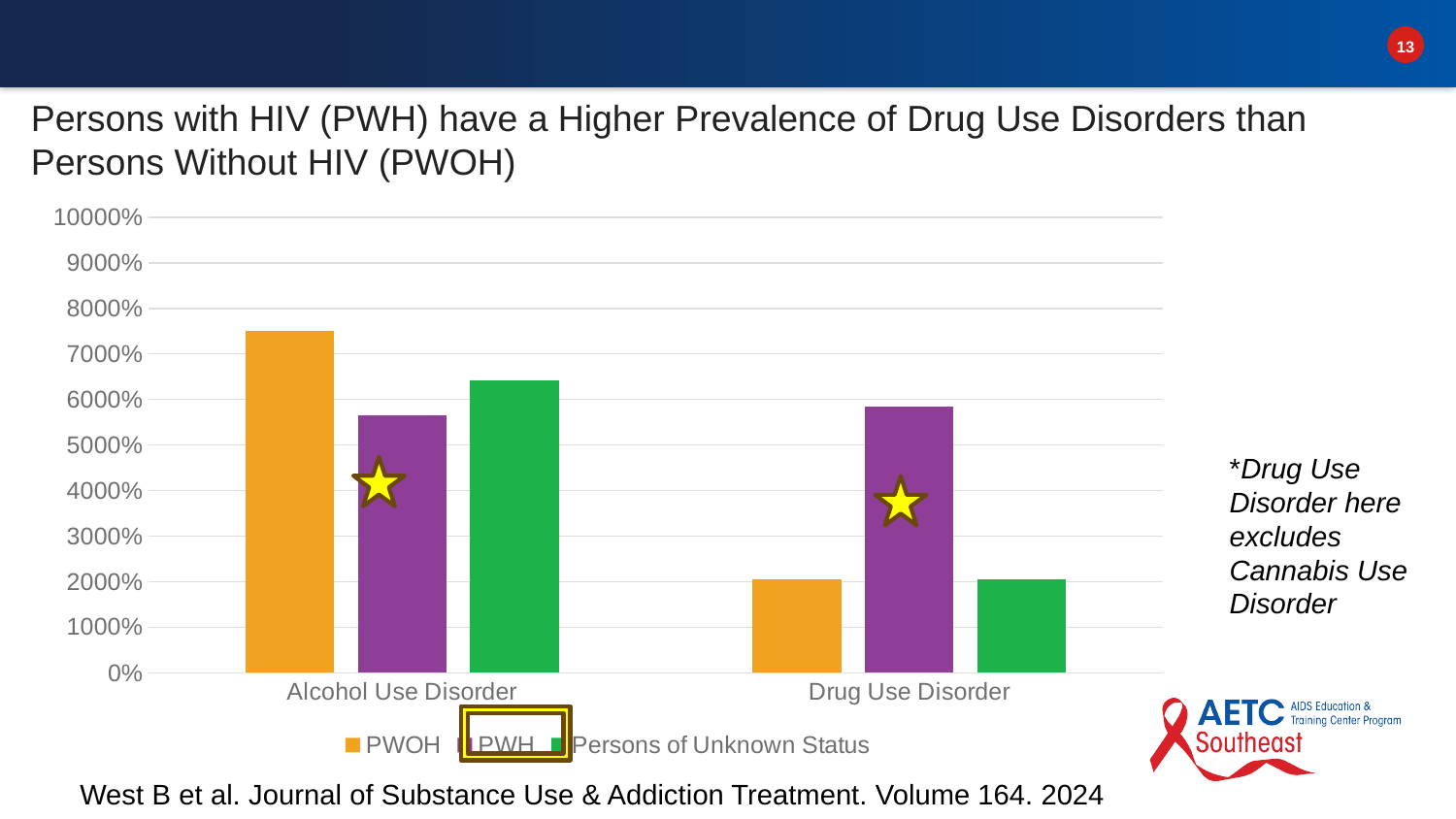
What kind of chart is shown on the slide? bar chart Which series has the highest value for Alcohol Use Disorder? PWOH Is the PWH value for Alcohol Use Disorder greater or less than 6000%? less Which series has the highest value for Drug Use Disorder? PWH Which series has the lowest value for Alcohol Use Disorder? PWH Is the PWH value for Drug Use Disorder greater or less than 5000%? greater Is the PWOH value for Alcohol Use Disorder greater or less than 7000%? greater What colour are the PWH bars in the chart? purple How many categories are shown on the x axis of the chart? 2 Is the PWOH value larger for Alcohol Use Disorder or for Drug Use Disorder? Alcohol Use Disorder How many series does the chart's legend list? 3